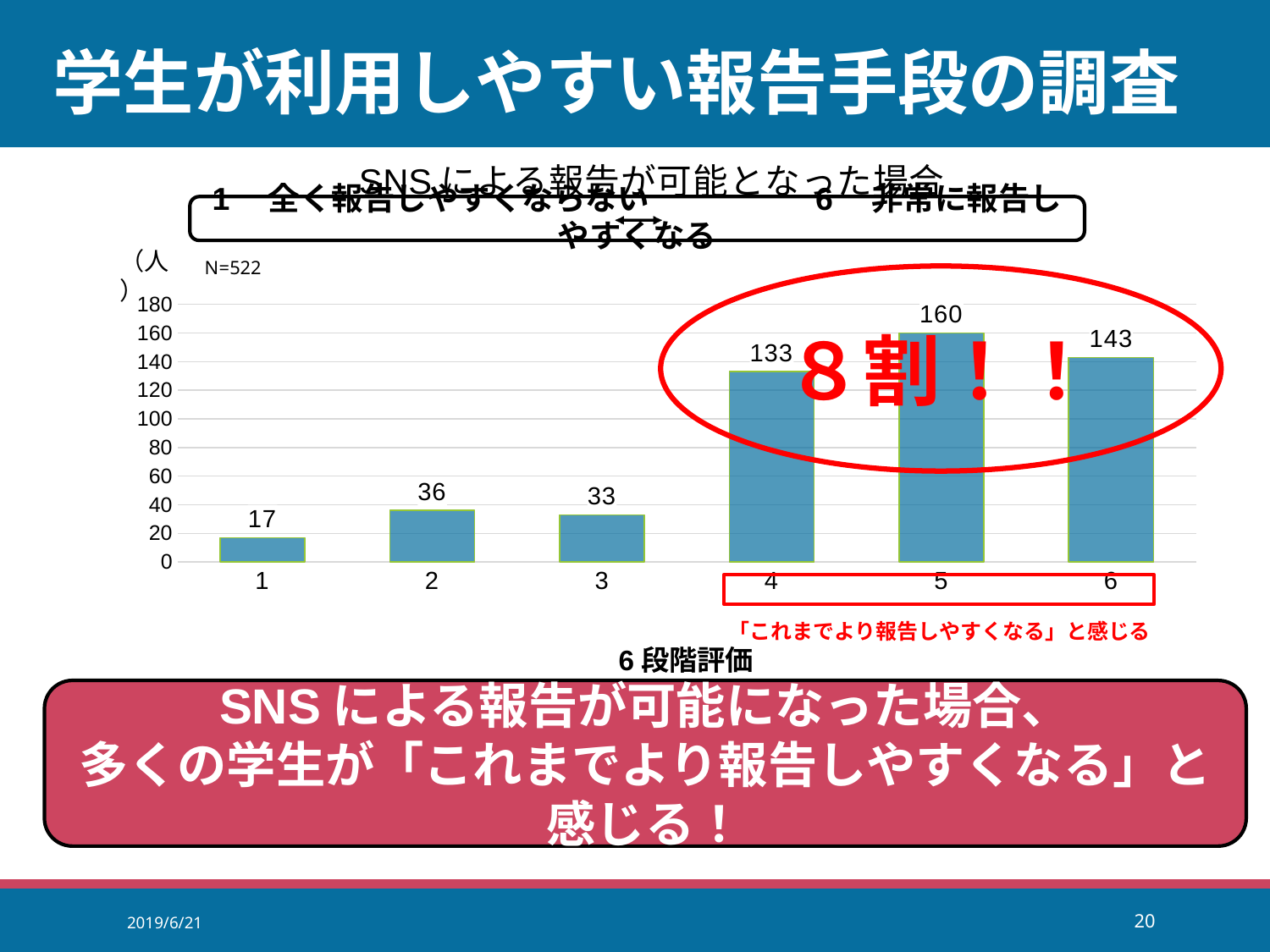
What kind of chart is shown on the slide? bar chart Which is larger, the value for rating 2 or the value for rating 3? rating 2 What is the value for rating 1? 17 Which rating category has the lowest value? 1 What is the value for rating 4? 133 How many rating categories are shown on the x axis? 6 What is the sample size (N) shown on the chart? N=522 Is the value for rating 6 greater or less than 140? greater What is the value for rating 5? 160 What is the difference between the values for rating 6 and rating 4? 10 Which rating category has the highest value? 5 What is the difference between the values for rating 2 and rating 3? 3